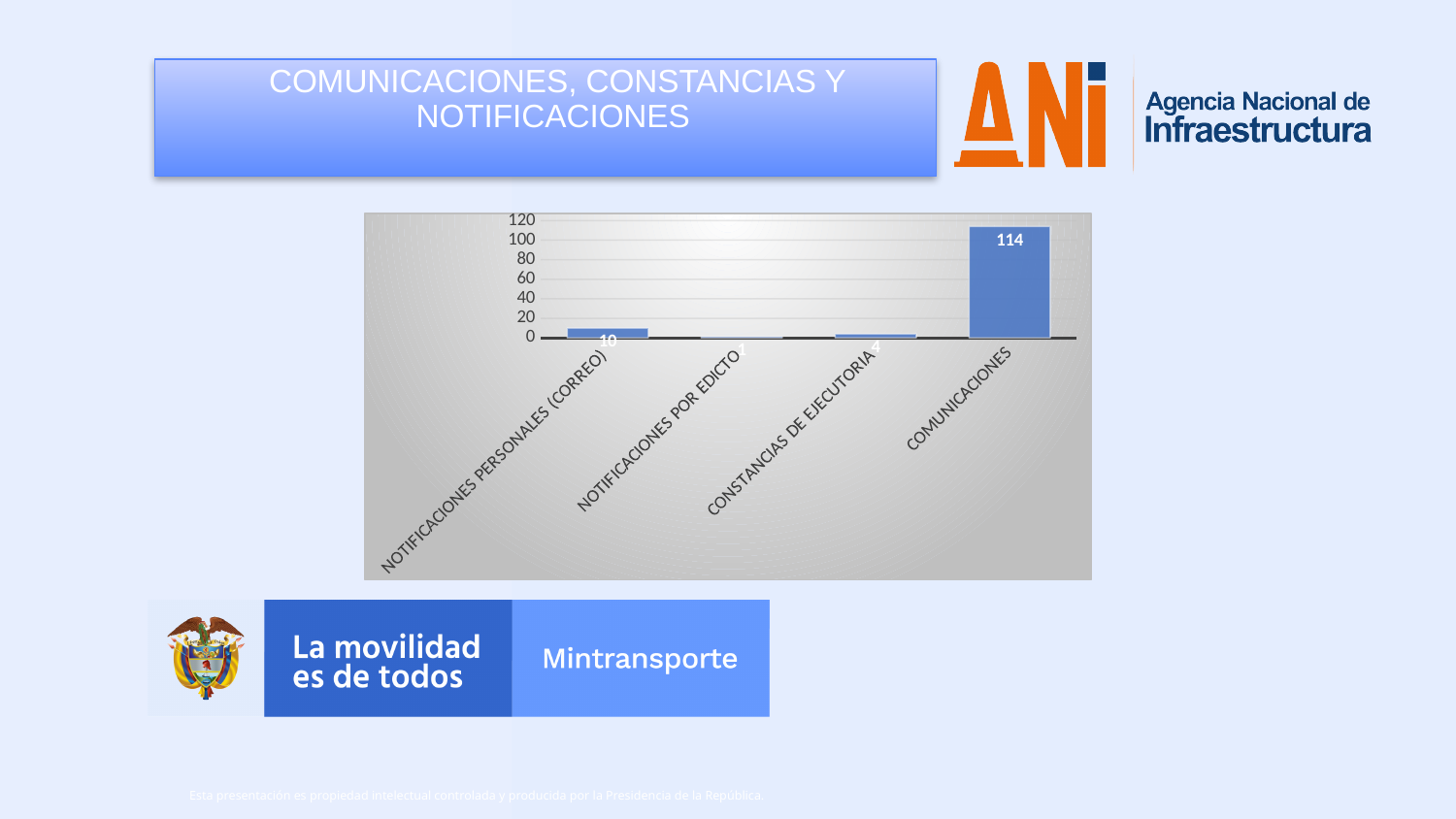
What is the value for CONSTANCIAS DE EJECUTORIA? 4 Which category has the lowest value? NOTIFICACIONES POR EDICTO Is the value for CONSTANCIAS DE EJECUTORIA greater or less than 20? less What is the highest value shown on the y axis? 120 What is the difference between the values for COMUNICACIONES and NOTIFICACIONES PERSONALES (CORREO)? 104 What is the value for COMUNICACIONES? 114 Which is larger, the value for NOTIFICACIONES PERSONALES (CORREO) or the value for CONSTANCIAS DE EJECUTORIA? NOTIFICACIONES PERSONALES (CORREO) What is the value for NOTIFICACIONES PERSONALES (CORREO)? 10 How many categories are shown on the x axis? 4 Is the value for COMUNICACIONES greater or less than 100? greater What kind of chart is shown on the slide? bar chart Which category has the highest value? COMUNICACIONES